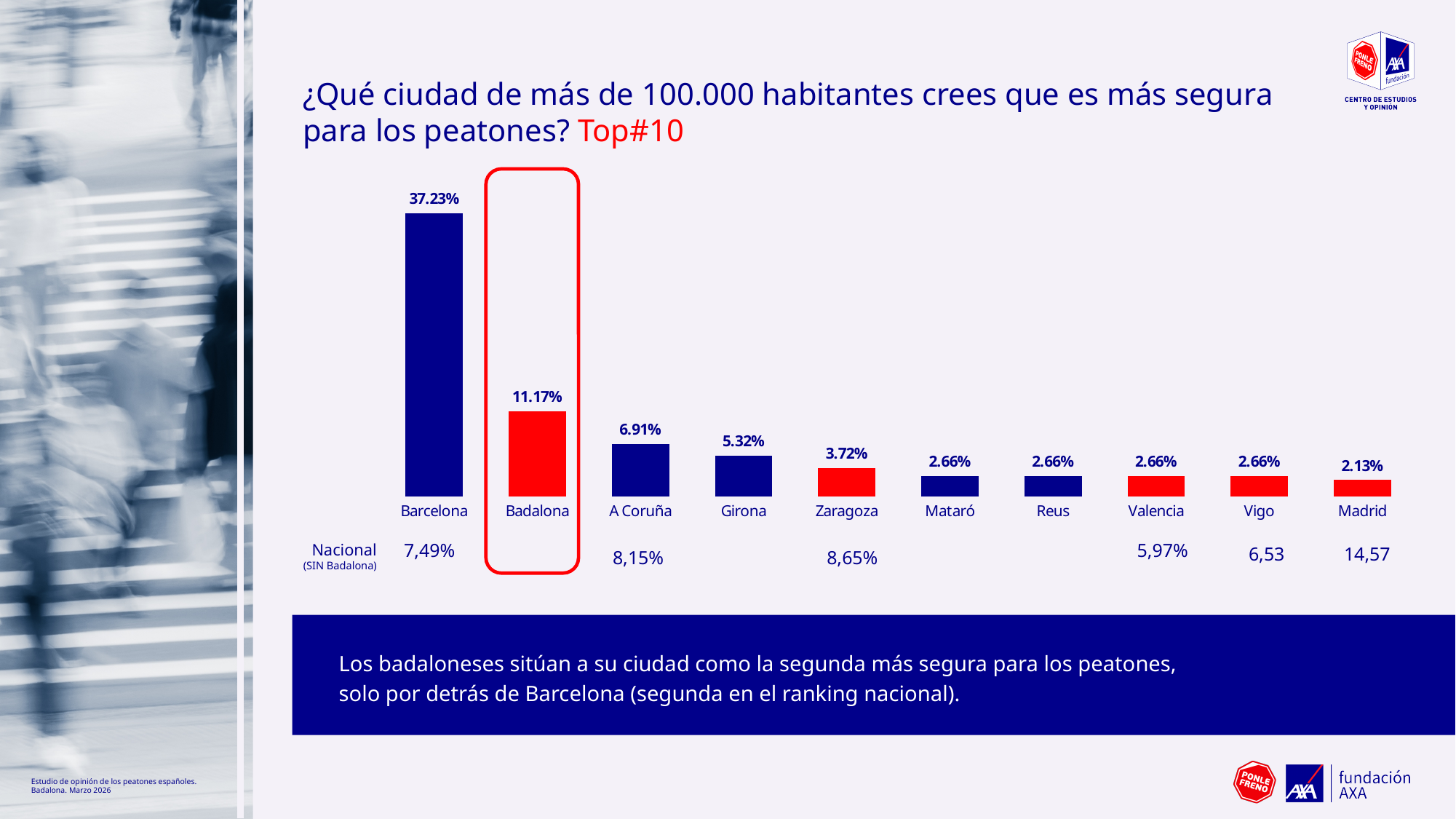
What percentage of respondents chose Barcelona as the safest city for pedestrians? 37.23% Which has a larger value, Girona or A Coruña? A Coruña What is the value shown for Badalona in the bar chart? 11.17% What is the difference between the values for Barcelona and Badalona? 26.06% Do the values rise or fall from left to right across the chart? Fall What value is shown for Zaragoza? 3.72% What value is shown for A Coruña? 6.91% What is the 'Nacional (SIN Badalona)' value shown under Madrid? 14,57 How many cities are shown in the bar chart? 10 What kind of chart is shown on the slide? Bar chart Which city has the lowest value in the chart? Madrid Which city has the highest value in the chart? Barcelona